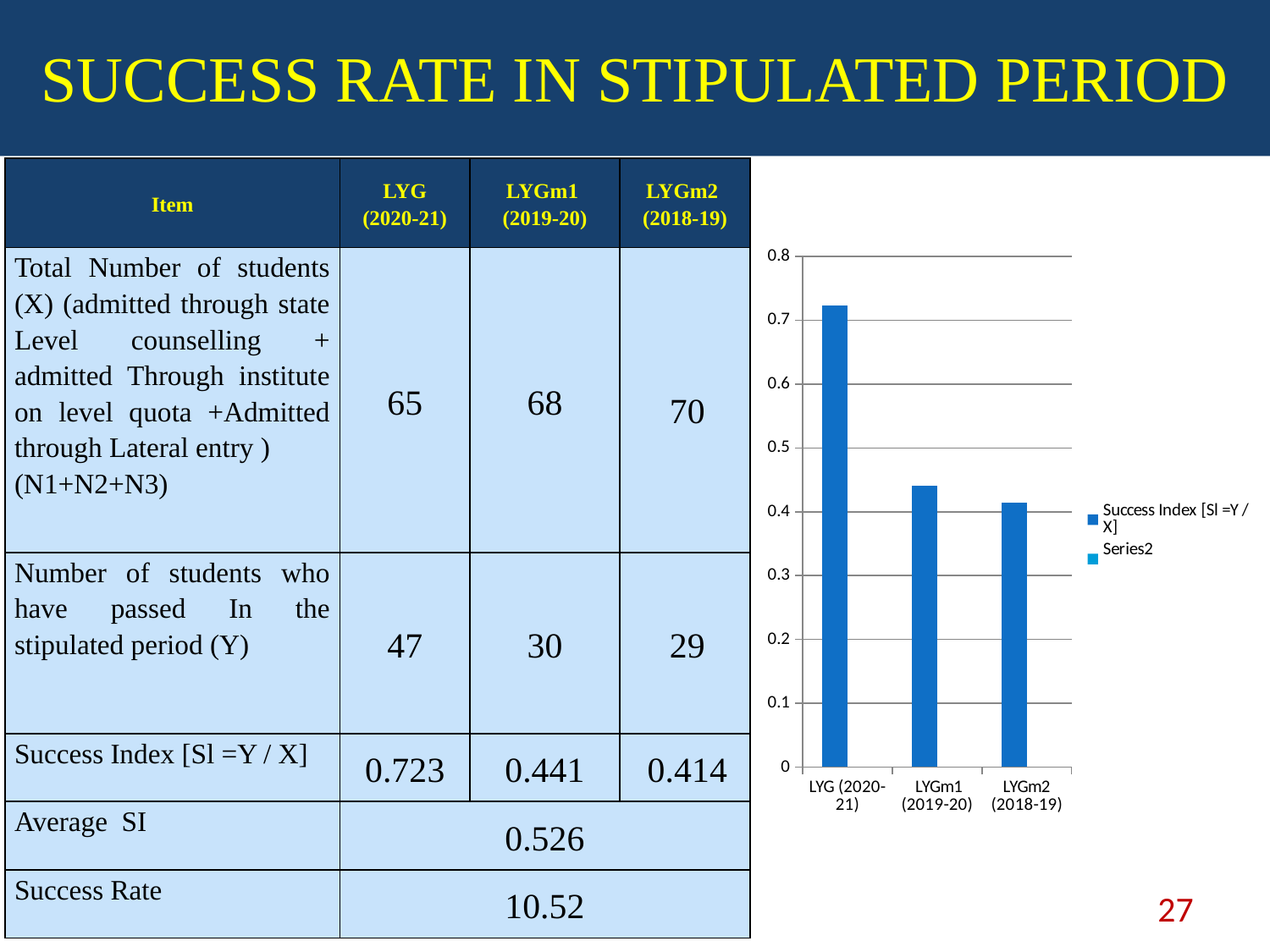
Which category has the tallest bar in the chart? LYG (2020-21) How many bars are plotted in the chart? 3 What is the highest value shown on the chart's vertical axis? 0.8 What is the name of the first series listed in the chart legend? Success Index [Sl =Y / X] What kind of chart is shown on the slide? bar chart Is the bar for LYGm1 (2019-20) greater or less than 0.5? less Which bar is taller, LYG (2020-21) or LYGm1 (2019-20)? LYG (2020-21) Do the bar values rise or fall from left to right across the x axis? fall Which category has the shortest bar in the chart? LYGm2 (2018-19) Is the bar for LYG (2020-21) greater or less than 0.7? greater How many series does the chart legend list? 2